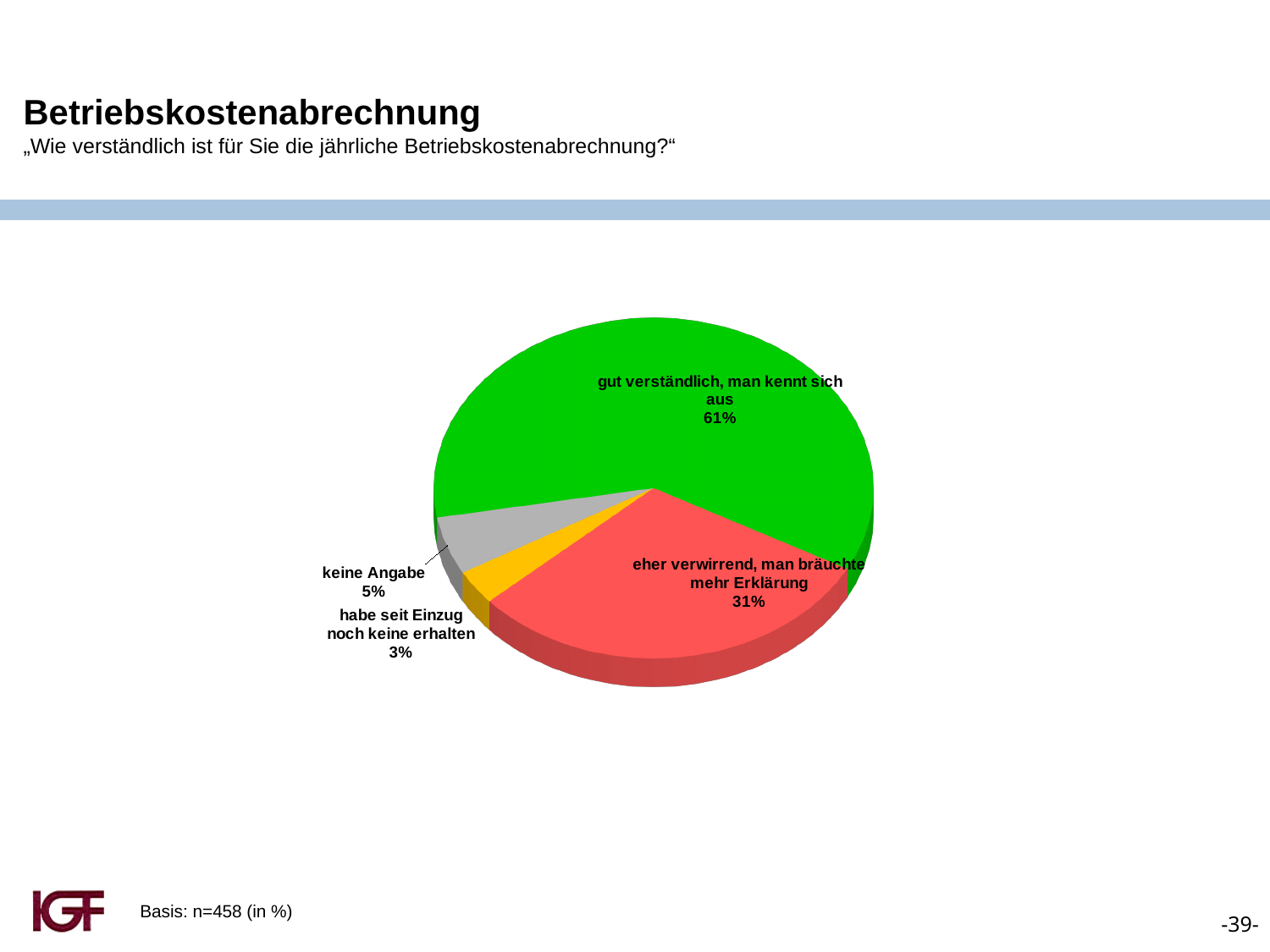
What kind of chart is shown on the slide? pie chart Which is larger: the share for "keine Angabe" or the share for "habe seit Einzug noch keine erhalten"? keine Angabe How many percentage points larger is the share for "gut verständlich, man kennt sich aus" than for "eher verwirrend, man bräuchte mehr Erklärung"? 30 percentage points What colour is the slice for "eher verwirrend, man bräuchte mehr Erklärung"? red What share of respondents answered "gut verständlich, man kennt sich aus"? 61% What share of respondents answered "habe seit Einzug noch keine erhalten"? 3% What share of respondents answered "eher verwirrend, man bräuchte mehr Erklärung"? 31% What is the sample size (Basis) stated on the slide? n=458 How many slices does the pie chart have? 4 What share of respondents gave "keine Angabe"? 5% Which answer category has the smallest share of the pie? habe seit Einzug noch keine erhalten Which answer category has the largest share of the pie? gut verständlich, man kennt sich aus